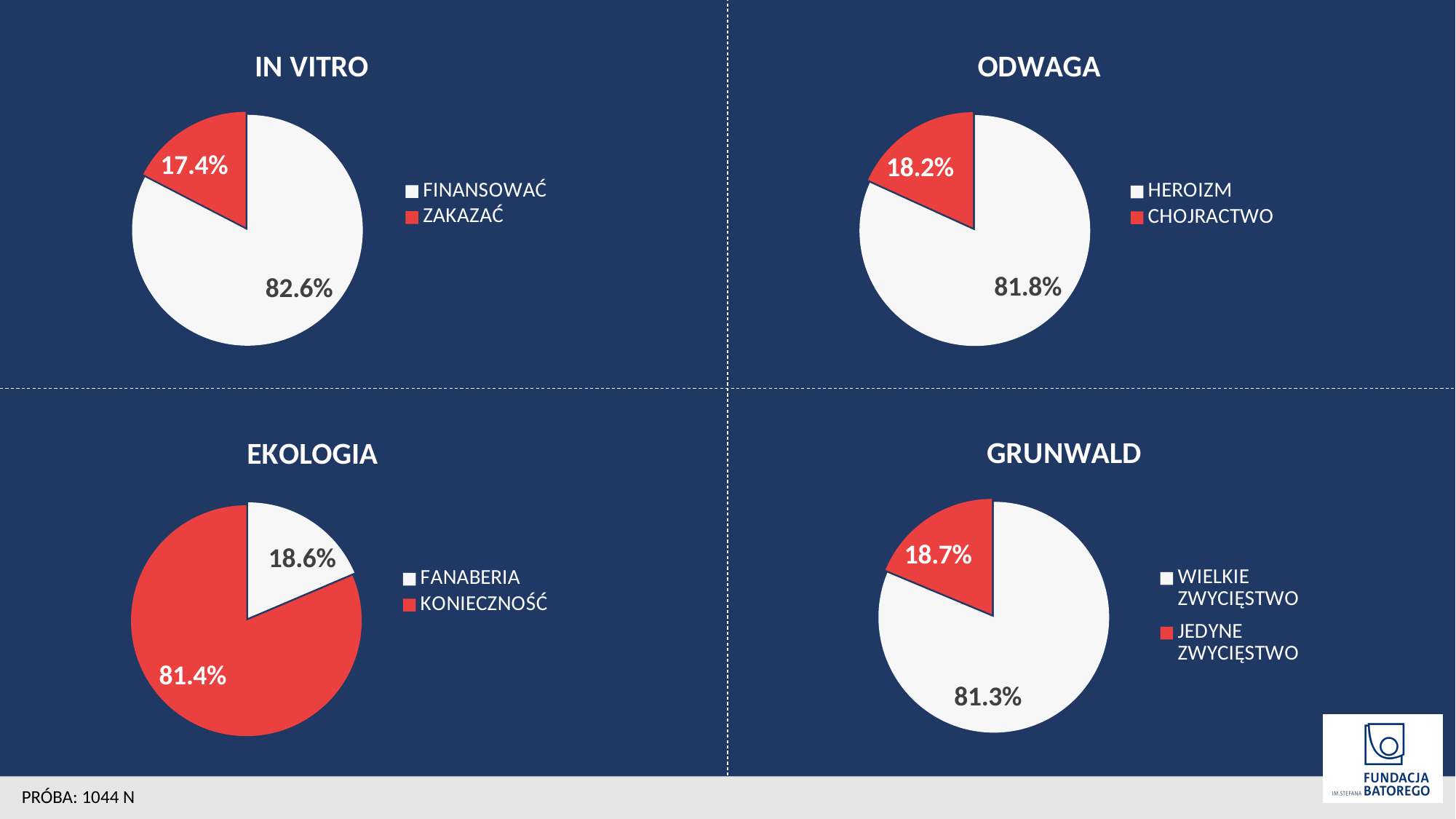
In the GRUNWALD chart, which slice is the largest? WIELKIE ZWYCIĘSTWO In the ODWAGA chart, what share is labelled for HEROIZM? 81.8% In the IN VITRO chart, what is the difference between the FINANSOWAĆ and ZAKAZAĆ shares? 65.2% What kind of chart is the ODWAGA chart? Pie chart In the EKOLOGIA chart, what share is labelled for KONIECZNOŚĆ? 81.4% In the IN VITRO chart, what share is labelled for FINANSOWAĆ? 82.6% In the EKOLOGIA chart, what share is labelled for FANABERIA? 18.6% In the GRUNWALD chart, what share is labelled for JEDYNE ZWYCIĘSTWO? 18.7% In the IN VITRO chart, what share is labelled for ZAKAZAĆ? 17.4% In the EKOLOGIA chart, which slice is the smallest? FANABERIA In the ODWAGA chart, what share is labelled for CHOJRACTWO? 18.2% How many entries does the legend of the EKOLOGIA chart list? 2